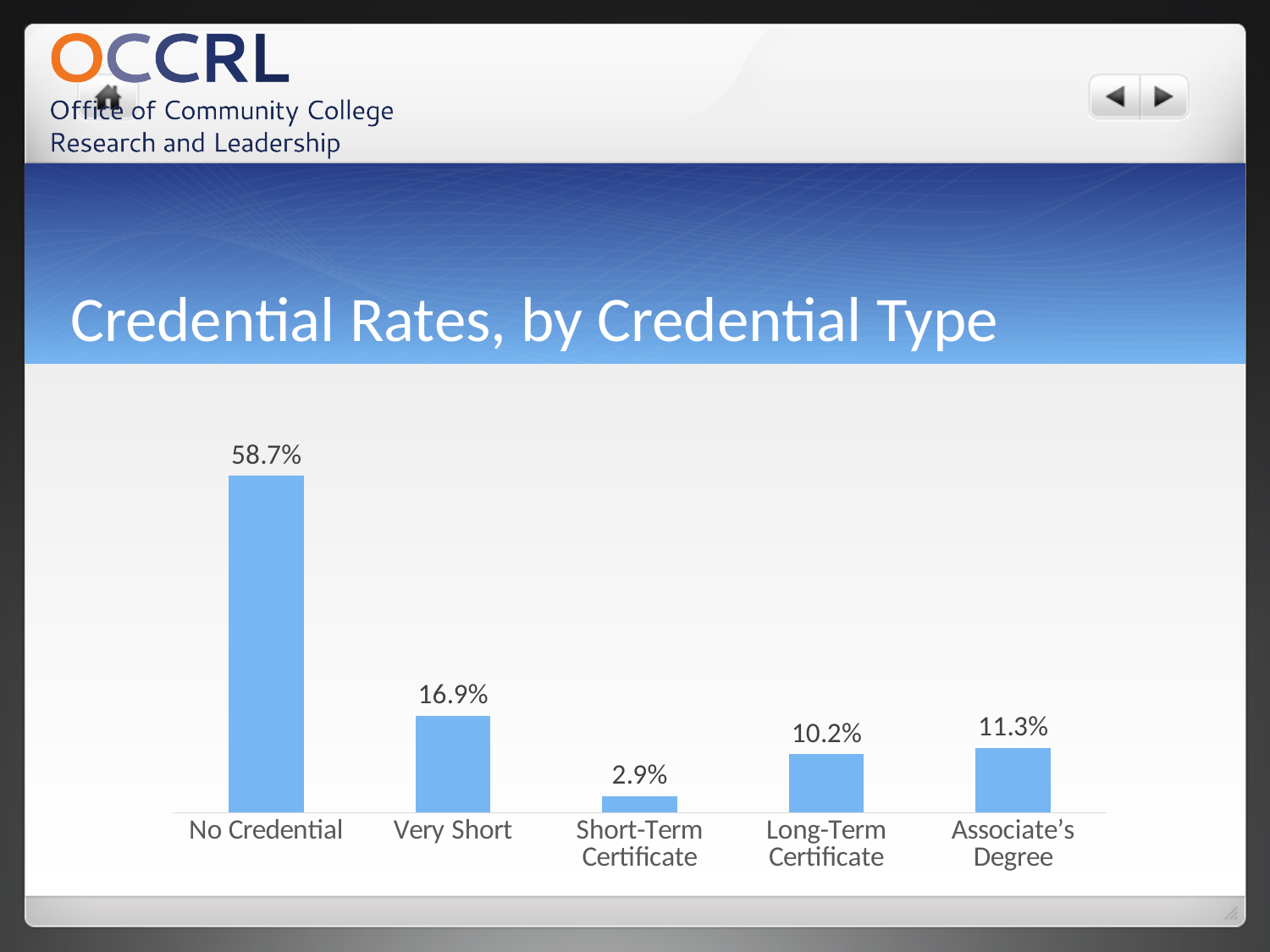
What is the credential rate for Long-Term Certificate? 10.2% Which credential type has the highest rate? No Credential What is the difference between the rates for No Credential and Very Short? 41.8% How many credential types are shown in the chart? 5 What is the credential rate for Associate's Degree? 11.3% Which is larger, the rate for Very Short or the rate for Associate's Degree? Very Short What is the credential rate for No Credential? 58.7% What is the credential rate for Short-Term Certificate? 2.9% What kind of chart is shown on the slide? Bar chart Which credential type has the lowest rate? Short-Term Certificate What is the credential rate for Very Short? 16.9% What is the difference between the rates for Associate's Degree and Long-Term Certificate? 1.1%